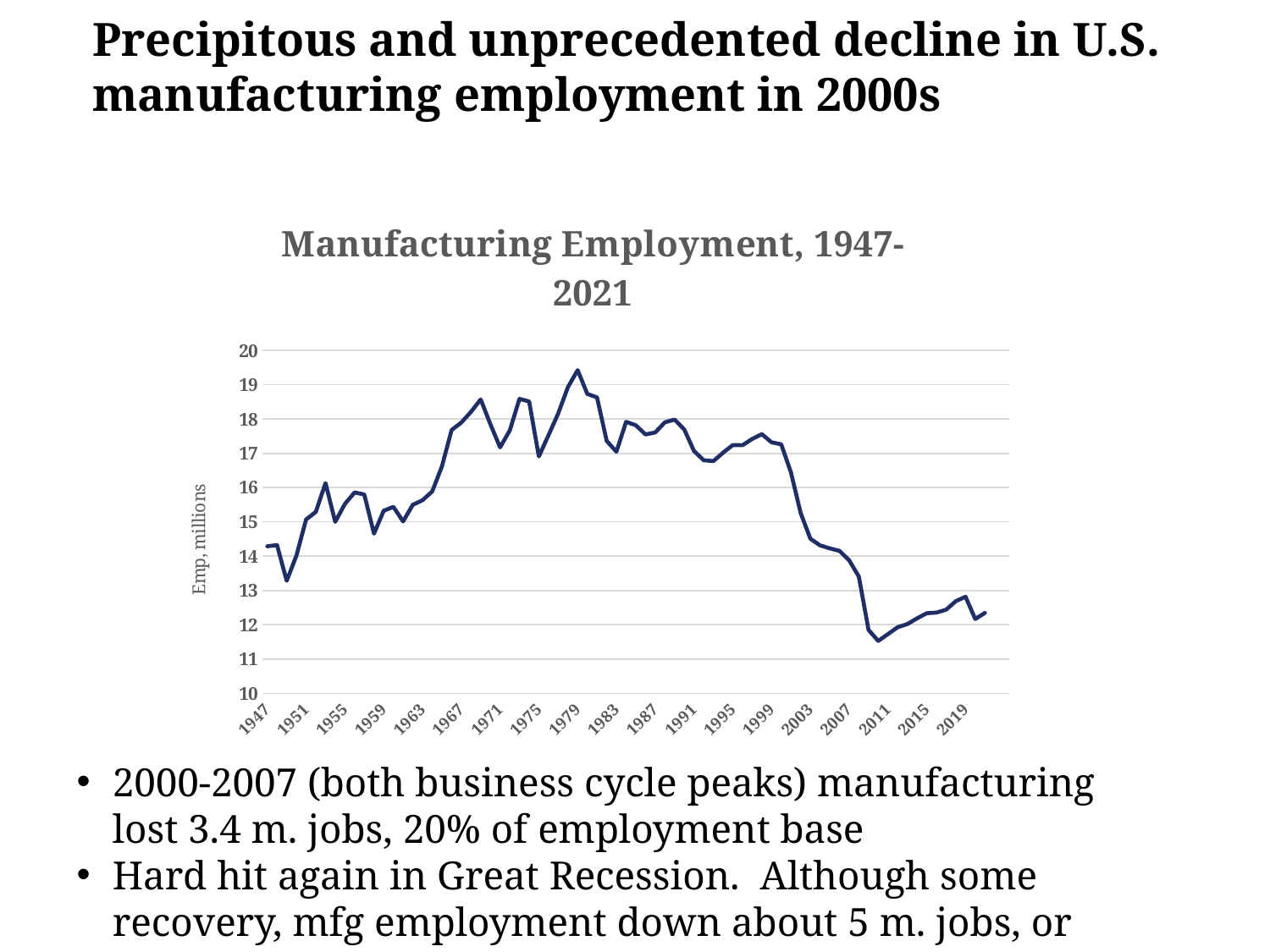
Which year has the larger value, 1979 or 2007? 1979 What is the label on the vertical axis of the chart? Emp, millions What kind of chart is shown on the slide? line chart Is the value for 2019 greater or less than 13? less In which labeled year does manufacturing employment reach its highest value on the chart? 1979 What is the title of the chart? Manufacturing Employment, 1947-2021 Is the value for 2003 greater or less than 15? less Do the values generally rise or fall between 1999 and 2011? fall Is the value for 1947 greater or less than 15? less